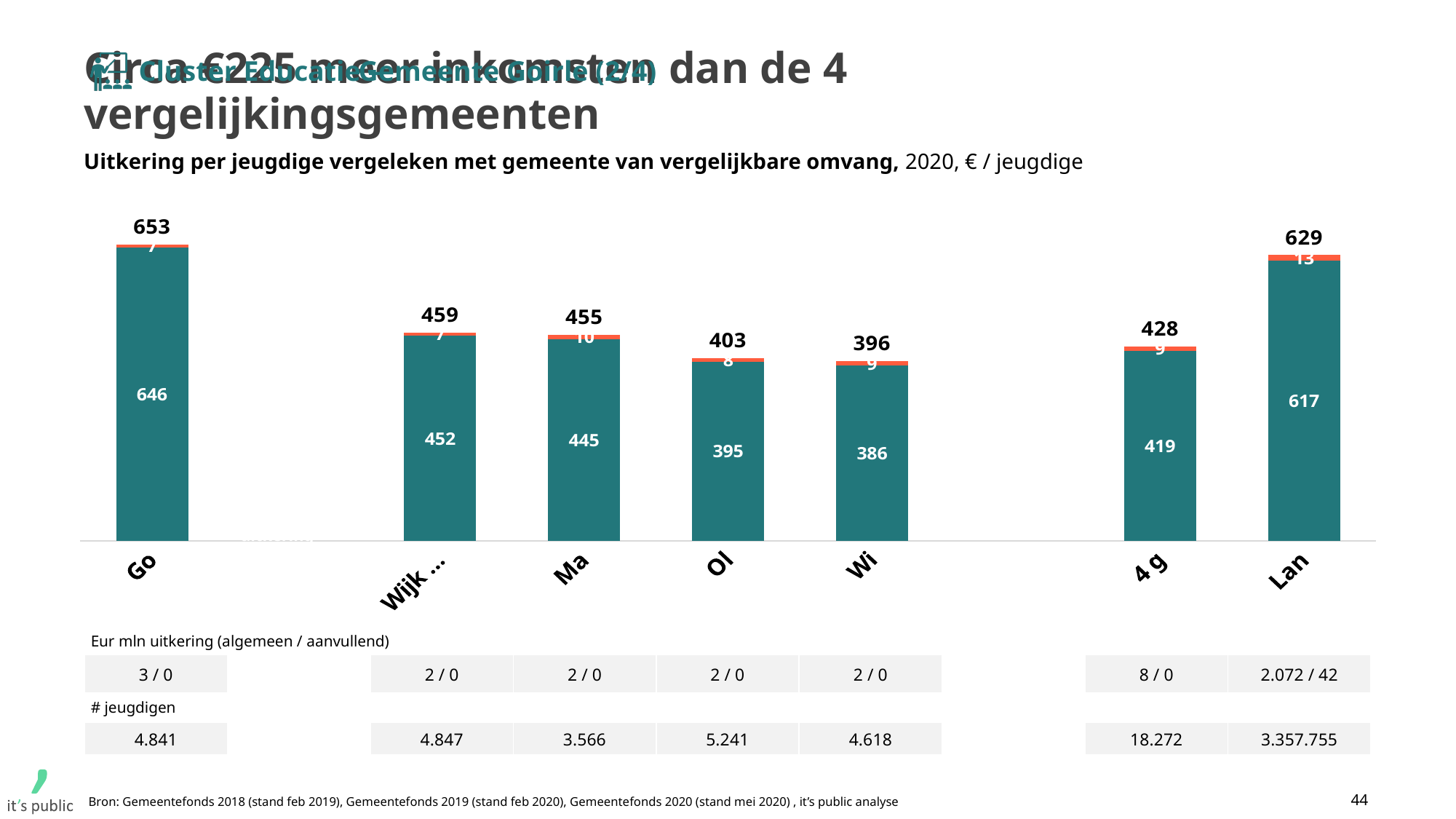
What is the difference between the total for Go and the total for 4 g? 225 Which category has the highest total value? Go What is the difference between the total for Ol and the total for Wi? 7 How many labelled bars are plotted in the chart? 7 What unit is stated in the chart subtitle for the plotted values? € / jeugdige What is the value of the teal (lower) segment of the bar for Ma? 445 Which category has the lowest total value? Wi What kind of chart is shown on the slide? Stacked bar chart What is the value of the teal (lower) segment of the bar for 4 g? 419 What is the total value shown above the bar for Lan? 629 Which has a larger total, Wijk ... or Ma? Wijk ... What is the total value shown above the bar for Go? 653